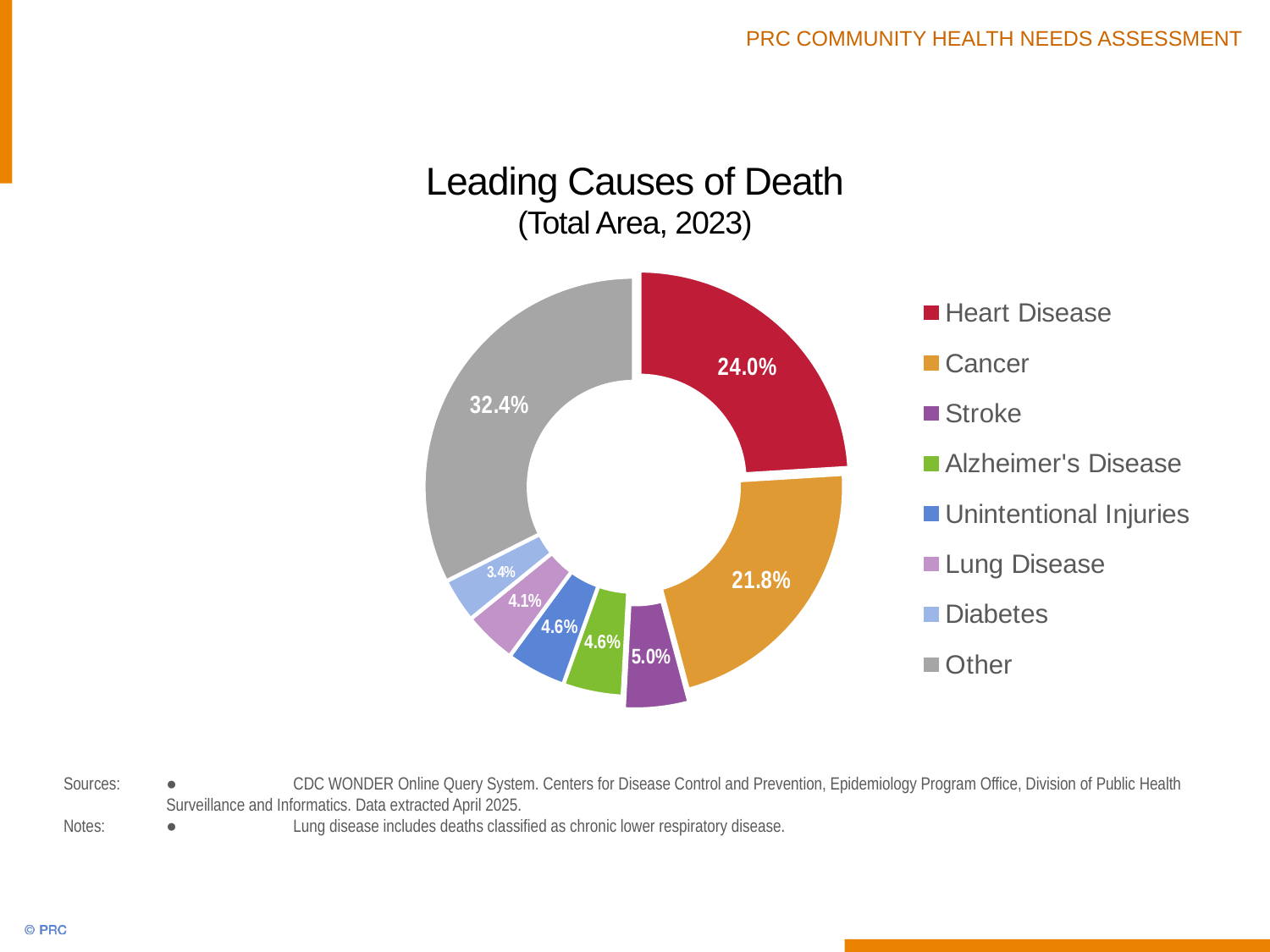
What share of deaths is attributed to Lung Disease? 4.1% What share of deaths is attributed to Diabetes? 3.4% What kind of chart is shown on the slide? Doughnut chart Which category has the largest slice of the pie? Other What is the difference in percentage points between Heart Disease and Cancer? 2.2 What is the title of the chart? Leading Causes of Death (Total Area, 2023) Which category has the smallest slice of the pie? Diabetes How many categories does the legend list? 8 What share of deaths is attributed to Cancer? 21.8% Which is larger, the share for Stroke or the share for Lung Disease? Stroke What share of deaths is attributed to Stroke? 5.0% What share of deaths is attributed to Heart Disease? 24.0%